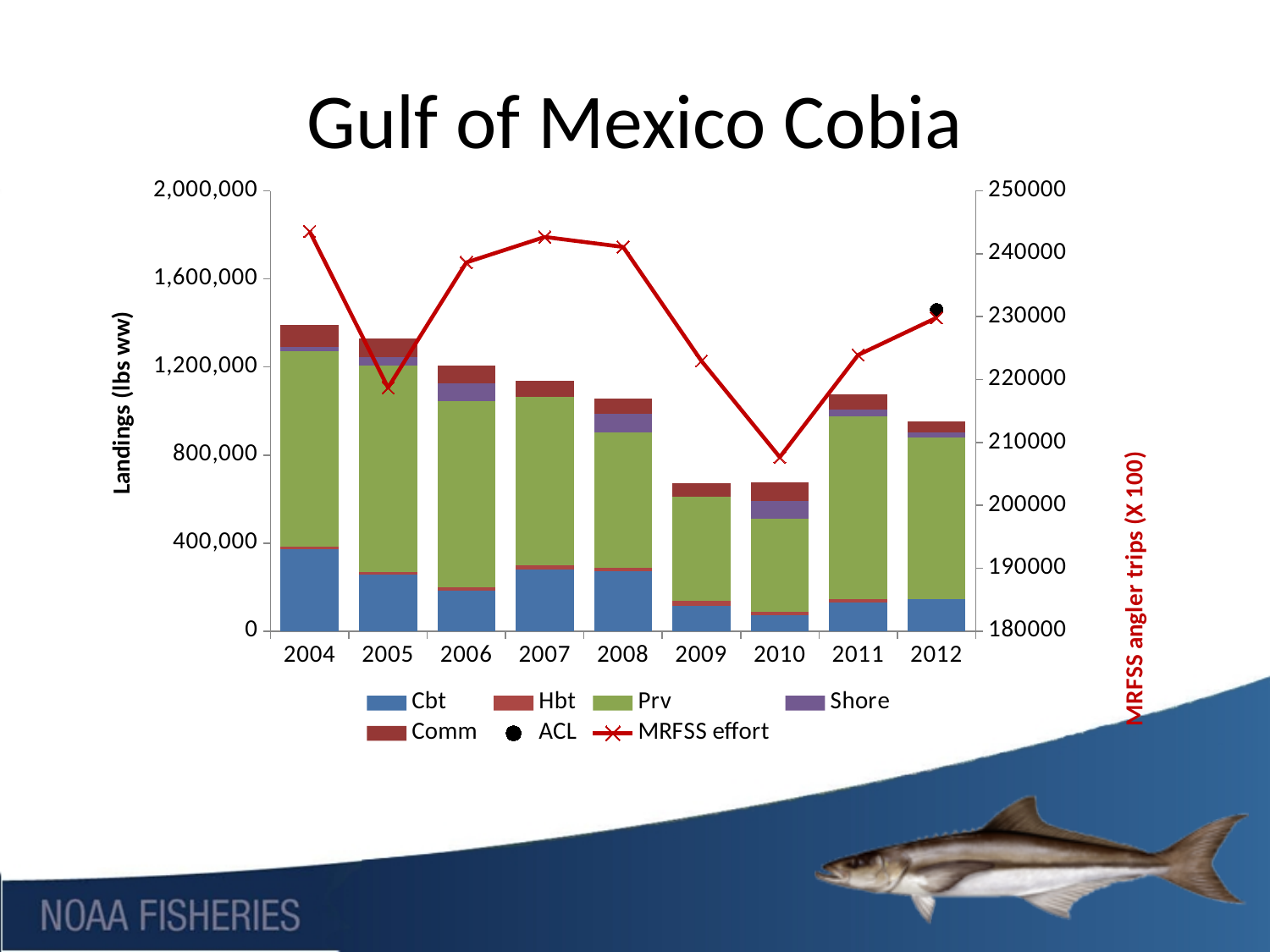
Is the MRFSS effort value for 2010 greater or less than 210000? less What kind of chart is used to show the landings by sector? bar chart How many entries does the legend list? 7 Is the total landings bar for 2004 greater or less than 1,200,000? greater Does the MRFSS effort line rise or fall from 2008 to 2010? fall Which year has the lowest MRFSS effort value? 2010 Is the total landings bar for 2009 greater or less than 800,000? less Which year has the highest total landings bar? 2004 What is the title of the chart? Gulf of Mexico Cobia How many years are shown on the x axis? 9 What is the label of the right-hand vertical axis? MRFSS angler trips (X 100) Which year has the larger total landings bar, 2008 or 2012? 2008